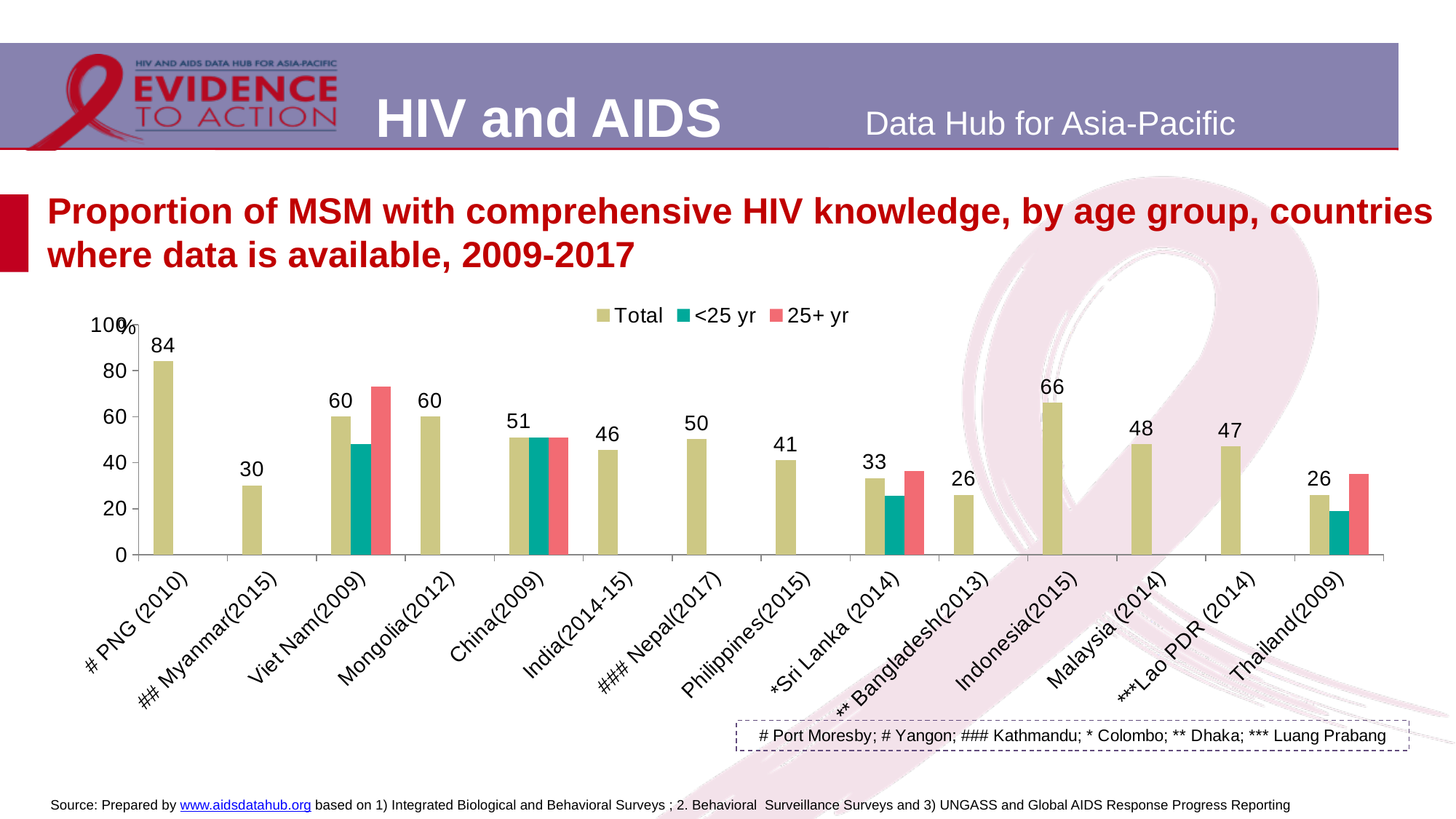
What is the Total value for Indonesia(2015)? 66 What is the Total value for # PNG (2010)? 84 Is the 25+ yr value for Viet Nam(2009) greater or less than 60? greater Is the <25 yr value for *Sri Lanka (2014) greater or less than 20? greater Is the 25+ yr value for Thailand(2009) greater or less than 30? greater What is the difference between the Total values for # PNG (2010) and ## Myanmar(2015)? 54 How many countries are shown on the x axis of the chart? 14 Which has a larger Total value, Indonesia(2015) or Malaysia (2014)? Indonesia(2015) What kind of chart is shown on the slide? Bar chart What is the Total value for ### Nepal(2017)? 50 How many series does the legend list? 3 Which country has the highest Total value? # PNG (2010)